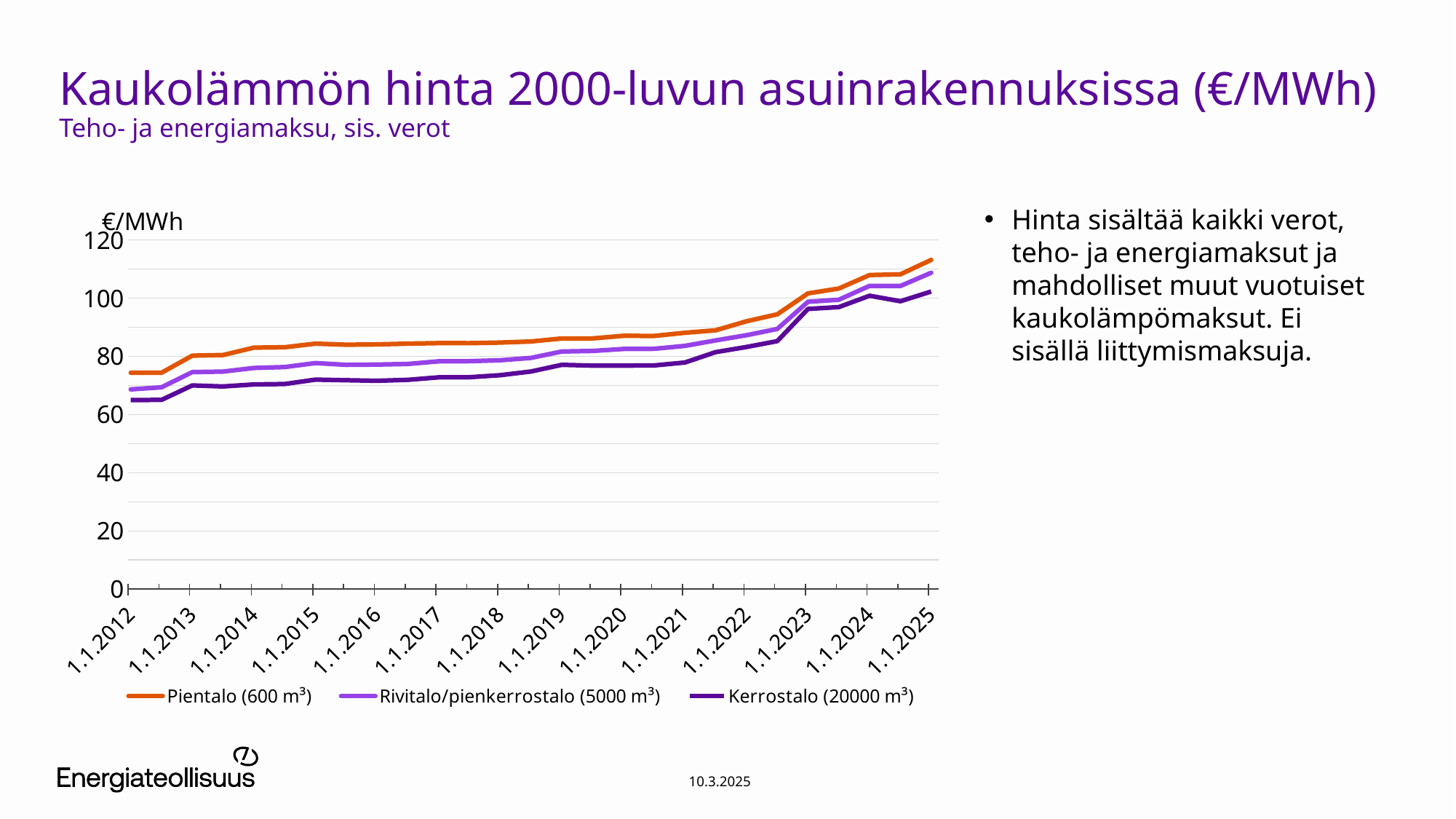
What unit is shown on the y axis of the chart? €/MWh How many dates are labelled on the x axis? 14 Which series has the highest values throughout the chart? Pientalo (600 m³) What kind of chart is shown on the slide? line chart Is the value for Kerrostalo (20000 m³) at 1.1.2018 greater or less than 80? less At 1.1.2025, which is larger: the value for Pientalo (600 m³) or for Kerrostalo (20000 m³)? Pientalo (600 m³) Do the values for Pientalo (600 m³) generally rise or fall from 1.1.2012 to 1.1.2025? rise How many series does the legend list? 3 Is the value for Kerrostalo (20000 m³) at 1.1.2025 greater or less than 100? greater Is the value for Pientalo (600 m³) at 1.1.2025 greater or less than 100? greater Which series has the lowest values throughout the chart? Kerrostalo (20000 m³)